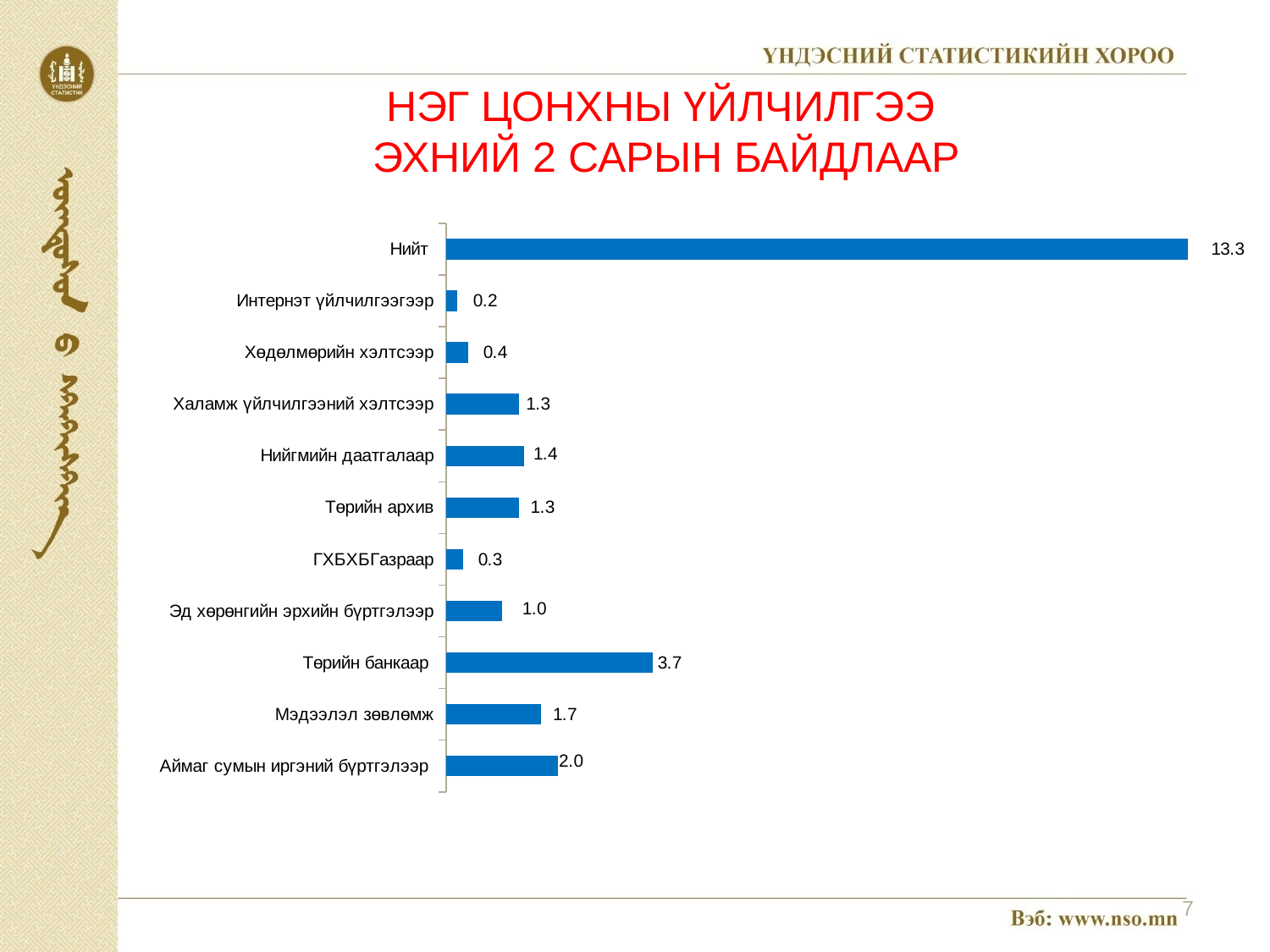
What kind of chart is shown on the slide? bar chart How many categories are shown in the chart? 11 What is the value for Төрийн банкаар? 3.7 What is the value for Аймаг сумын иргэний бүртгэлээр? 2.0 What is the value for Интернэт үйлчилгээгээр? 0.2 What is the value for Нийгмийн даатгалаар? 1.4 What is the value for Нийт? 13.3 Which is larger, the value for Хөдөлмөрийн хэлтсээр or the value for ГХБХБГазраар? Хөдөлмөрийн хэлтсээр Which category has the highest value? Нийт Which category has the lowest value? Интернэт үйлчилгээгээр What is the difference between the values for Төрийн банкаар and Мэдээлэл зөвлөмж? 2.0 Excluding Нийт, which category has the highest value? Төрийн банкаар